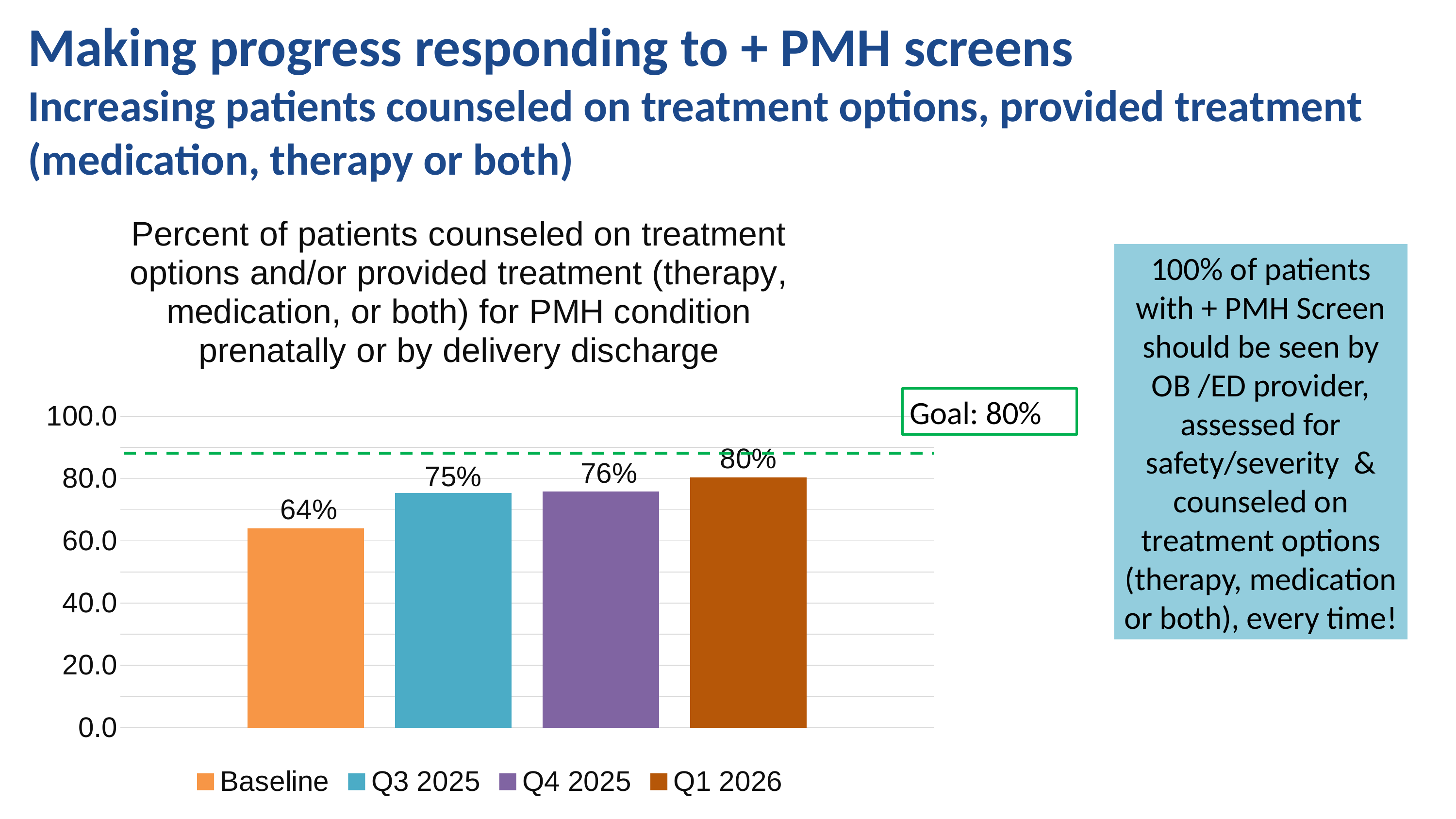
Is the value for Baseline greater or less than 80? less What is the value for Baseline? 64% Which is larger, the value for Baseline or the value for Q3 2025? Q3 2025 What goal value is labeled on the chart? 80% What is the value for Q4 2025? 76% What is the value for Q3 2025? 75% What is the difference between the Q1 2026 value and the Baseline value? 16% How many bars are shown in the chart? 4 Which period has the lowest value? Baseline Which period has the highest value? Q1 2026 What kind of chart is shown on the slide? bar chart What is the value for Q1 2026? 80%